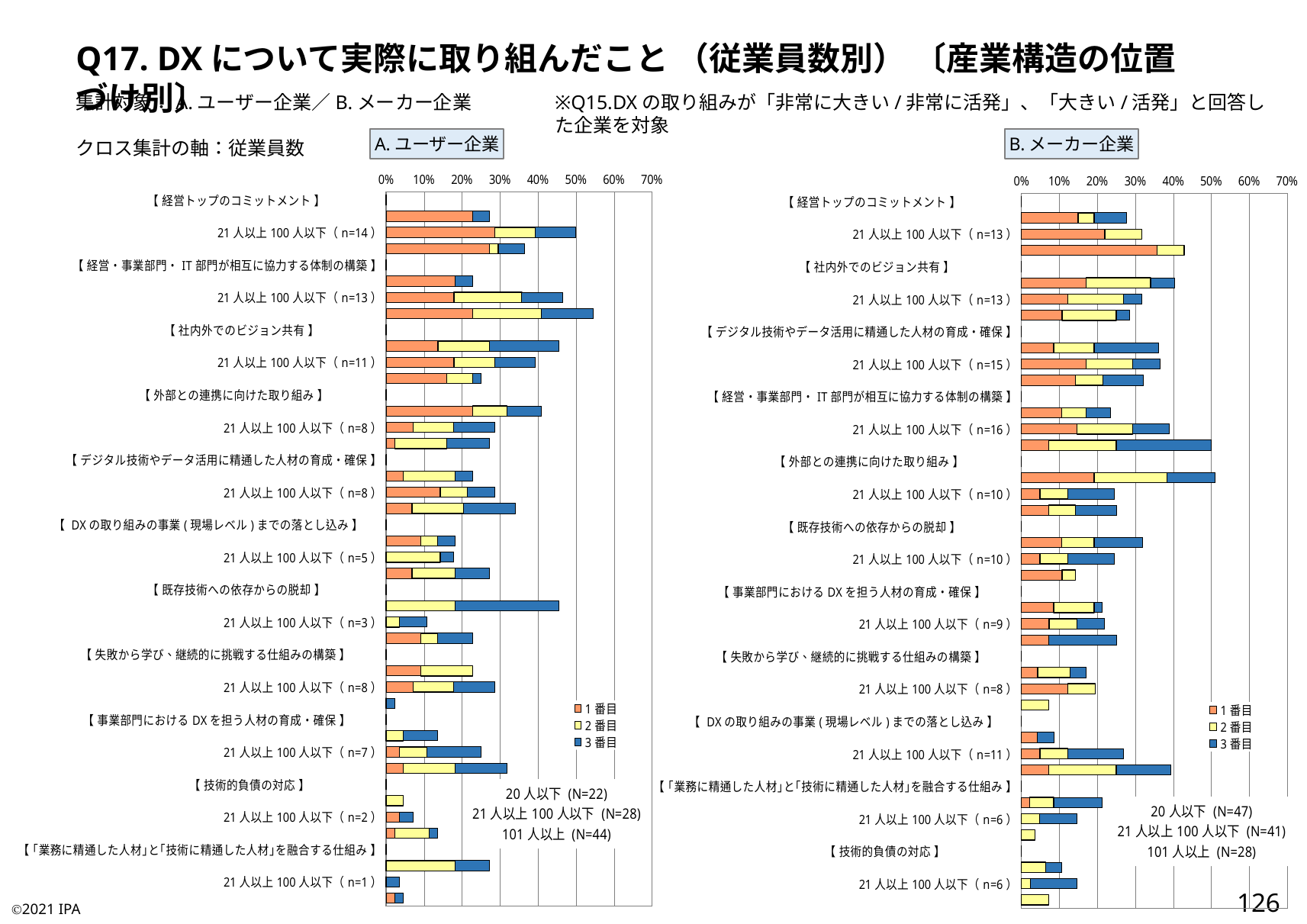
What is the maximum value shown on the x axis of the B. メーカー企業 chart? 70% What are the legend entries of the A. ユーザー企業 chart? 1番目, 2番目, 3番目 In the B. メーカー企業 chart, is the total stacked bar for 101人以上 under 失敗から学び、継続的に挑戦する仕組みの構築 greater or less than 10%? less In the A. ユーザー企業 chart, is the total stacked bar for 101人以上 under 経営・事業部門・IT部門が相互に協力する体制の構築 greater or less than 50%? greater In the A. ユーザー企業 chart, is the total stacked bar for 20人以下 under 経営トップのコミットメント greater or less than 20%? greater How many item categories (bracketed headings) are shown in the B. メーカー企業 chart? 11 What kind of chart is the A. ユーザー企業 chart? Stacked horizontal bar chart How many item categories (bracketed headings) are shown in the A. ユーザー企業 chart? 11 How many series does the legend of the B. メーカー企業 chart list? 3